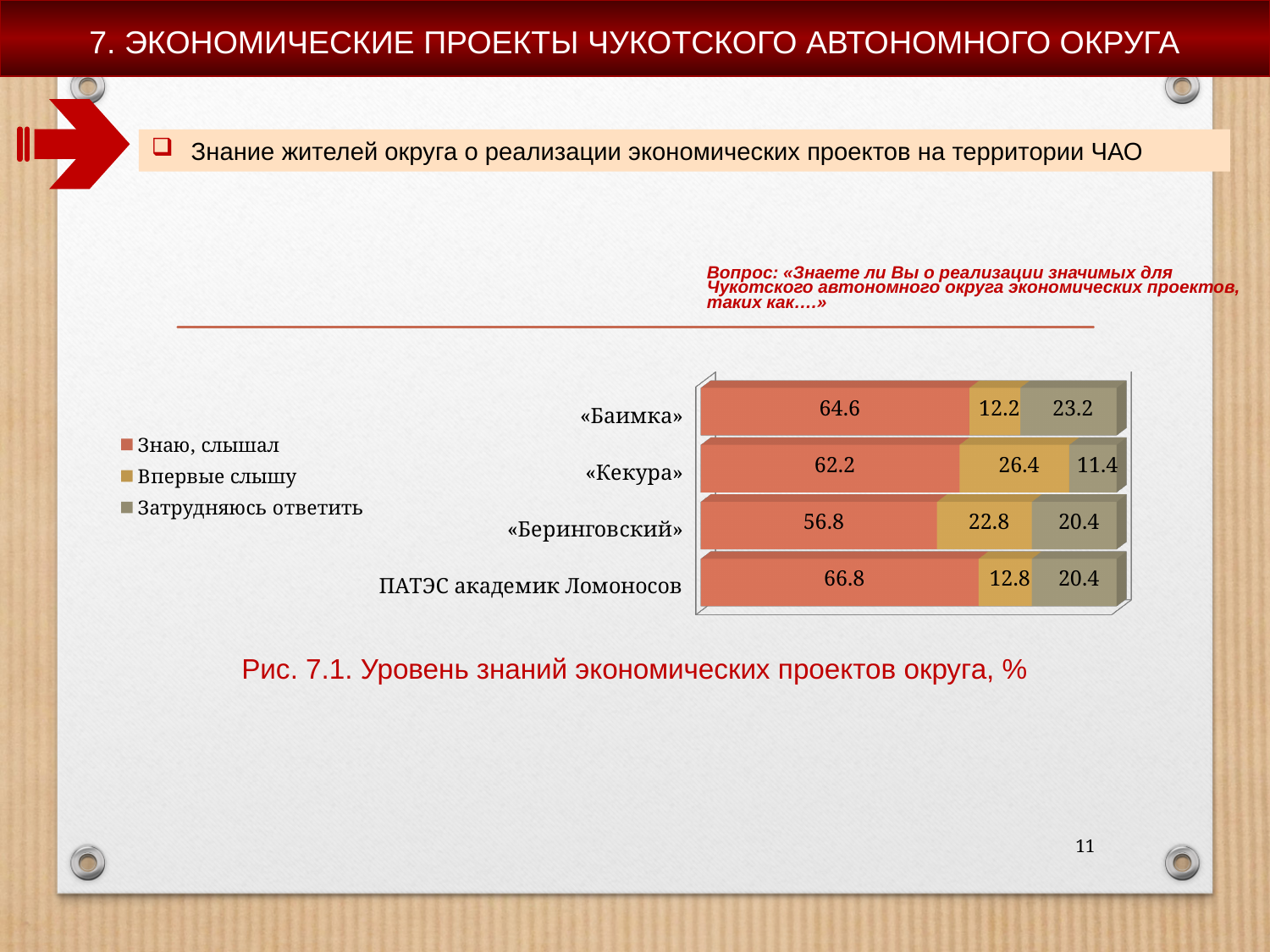
What is the difference between the «Знаю, слышал» values for ПАТЭС академик Ломоносов and «Беринговский»? 10.0 What is the value of «Затрудняюсь ответить» for «Беринговский»? 20.4 Which is larger: the «Впервые слышу» value for «Кекура» or for «Беринговский»? «Кекура» What type of chart is shown on the slide? Stacked bar chart What is the caption (figure title) of the chart? Рис. 7.1. Уровень знаний экономических проектов округа, % What is the value of «Впервые слышу» for «Кекура»? 26.4 Which project has the highest value for «Знаю, слышал»? ПАТЭС академик Ломоносов What is the value of «Знаю, слышал» for «Баимка»? 64.6 What is the total of the stacked bar for «Баимка»? 100.0 Which project has the lowest value for «Знаю, слышал»? «Беринговский» How many projects (categories) are shown in the chart? 4 How many series does the legend list? 3